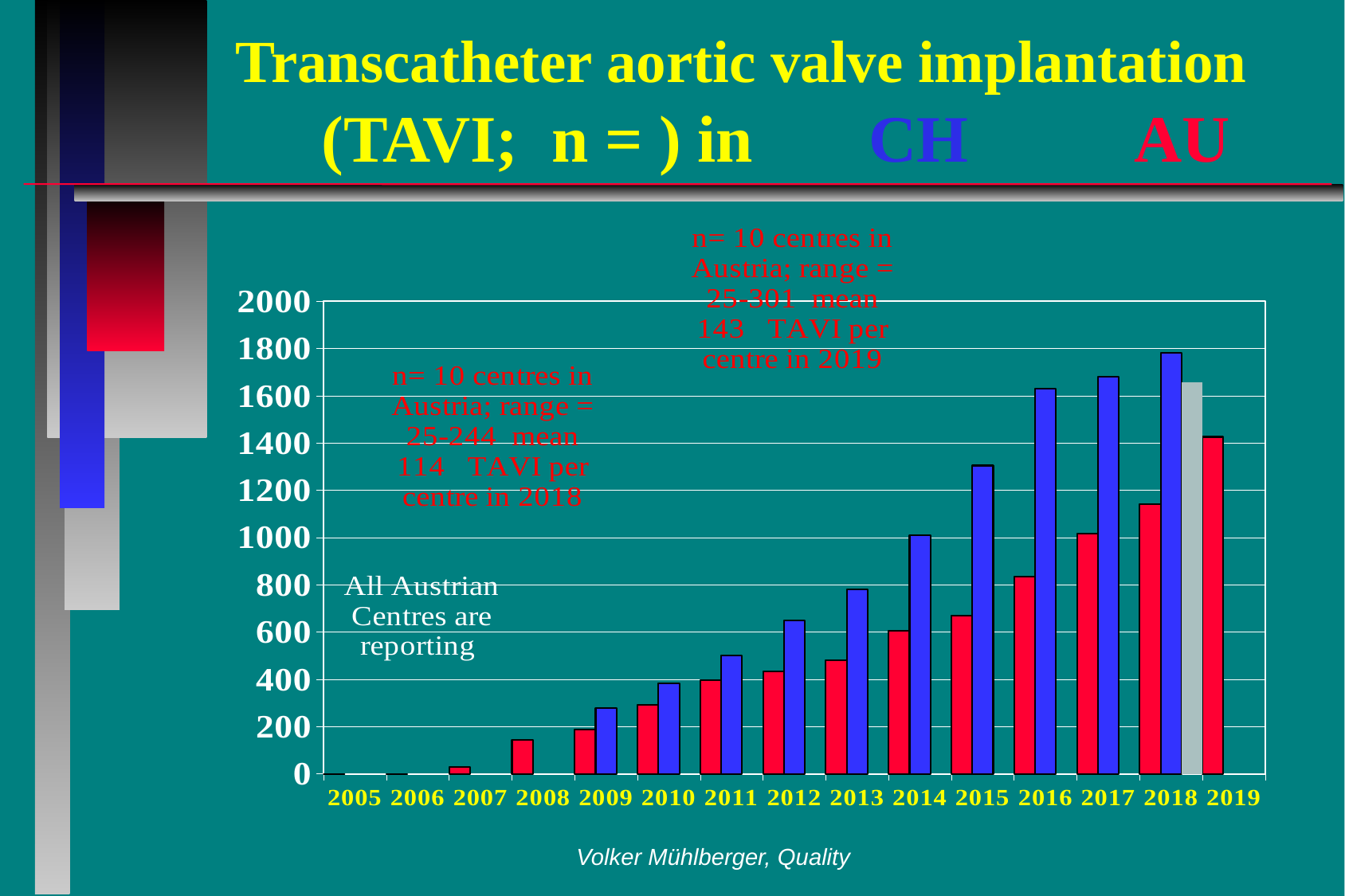
Do the red (AU) bars generally rise or fall from 2007 to 2019? rise According to the slide title, which colour represents CH? blue What is the highest value shown on the y axis? 2000 Is the blue (CH) bar for 2016 greater or less than 1400? greater Is the red (AU) bar for 2014 greater or less than 800? less Is the red (AU) bar for 2019 greater or less than 1200? greater How many years are shown on the x axis of the chart? 15 In 2015, which bar is taller, the blue (CH) bar or the red (AU) bar? blue (CH) Which year has the tallest blue (CH) bar? 2018 What kind of chart is shown on the slide? bar chart